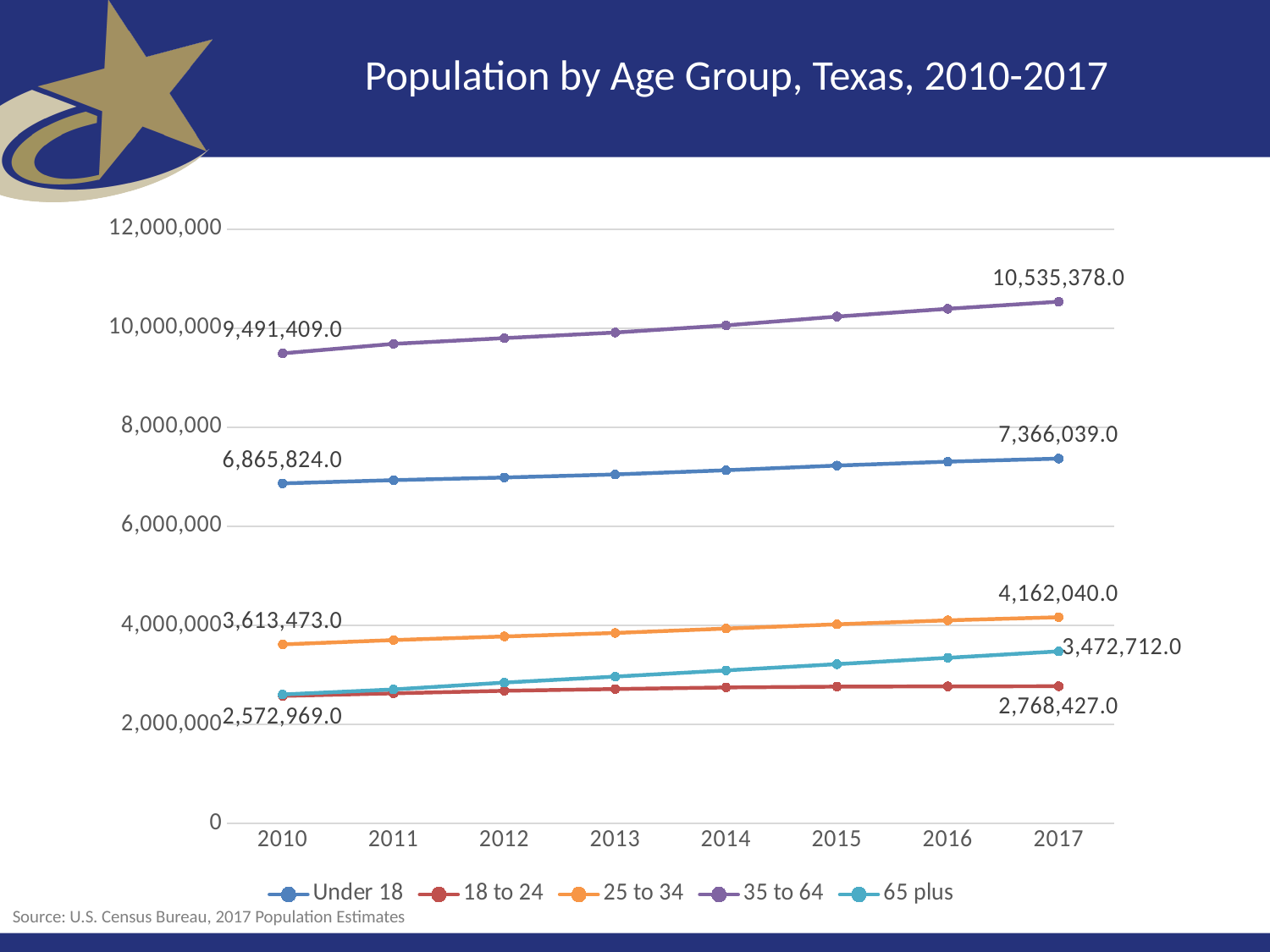
Does the population of the 35 to 64 age group rise or fall from 2010 to 2017? rise What is the population of the Under 18 age group in 2010? 6,865,824.0 In 2017, which is larger: the 65 plus population or the 18 to 24 population? 65 plus By how much did the population of the 35 to 64 age group increase from 2010 to 2017? 1,043,969.0 What is the population of the 25 to 34 age group in 2017? 4,162,040.0 How many years are plotted along the x axis? 8 What is the population of the 65 plus age group in 2017? 3,472,712.0 What type of chart is shown on the slide? line chart How many series does the legend list? 5 Is the Under 18 population in 2014 greater or less than 8,000,000? less Which age group has the highest population in 2017? 35 to 64 What is the population of the 35 to 64 age group in 2017? 10,535,378.0